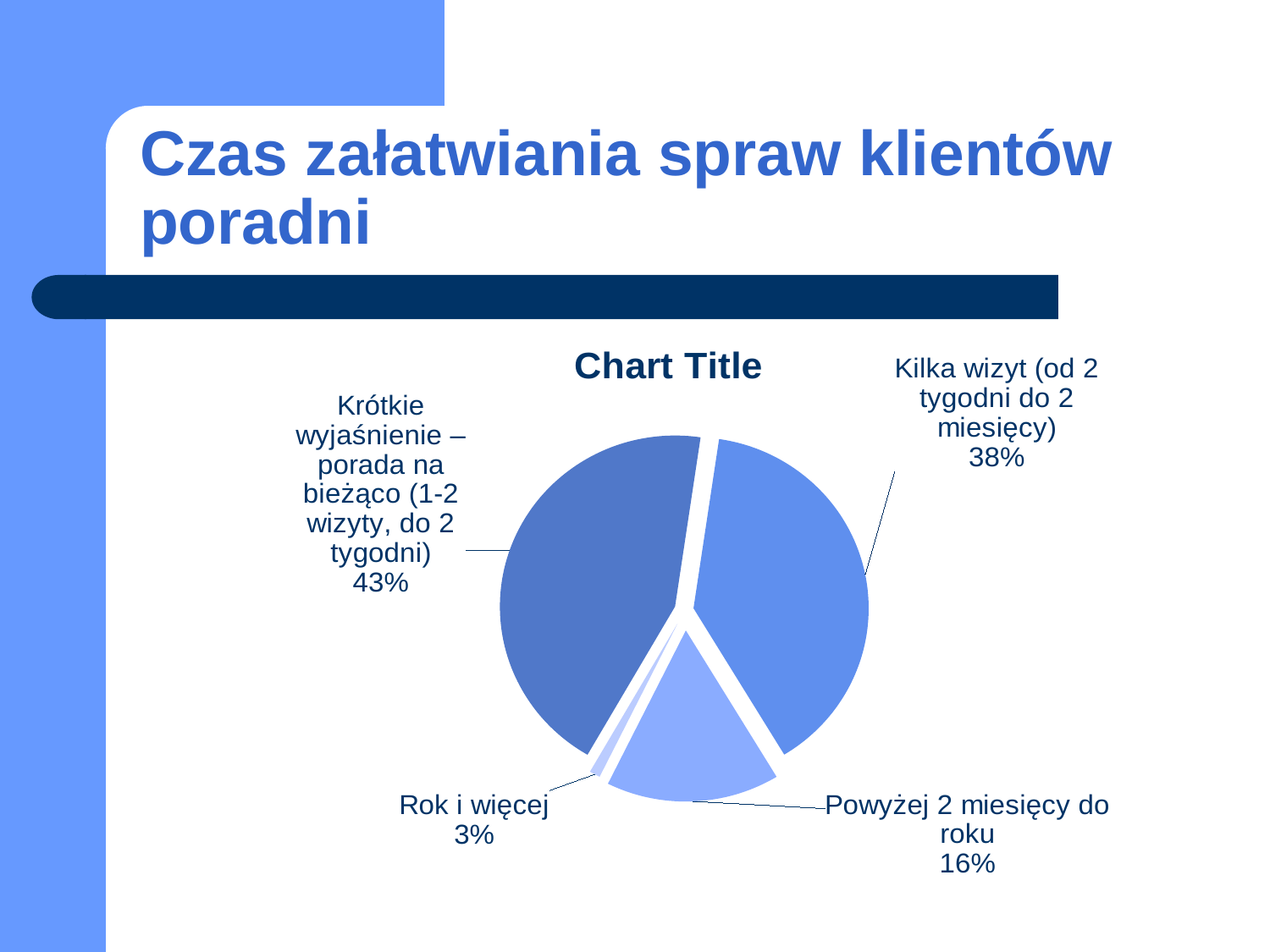
What share of the pie does "Powyżej 2 miesięcy do roku" have? 16% What is the title shown above the pie chart? Chart Title Which category has the largest slice of the pie? Krótkie wyjaśnienie – porada na bieżąco (1-2 wizyty, do 2 tygodni) What type of chart is shown on the slide? pie chart Which category has the smallest slice of the pie? Rok i więcej Which is larger: the share for "Powyżej 2 miesięcy do roku" or the share for "Rok i więcej"? Powyżej 2 miesięcy do roku What is the difference in percentage points between "Kilka wizyt (od 2 tygodni do 2 miesięcy)" and "Powyżej 2 miesięcy do roku"? 22 percentage points What share of the pie does "Rok i więcej" have? 3% How many slices does the pie chart have? 4 What share of the pie does "Kilka wizyt (od 2 tygodni do 2 miesięcy)" have? 38% What share of the pie does "Krótkie wyjaśnienie – porada na bieżąco (1-2 wizyty, do 2 tygodni)" have? 43% What is the combined share of "Rok i więcej" and "Powyżej 2 miesięcy do roku"? 19%